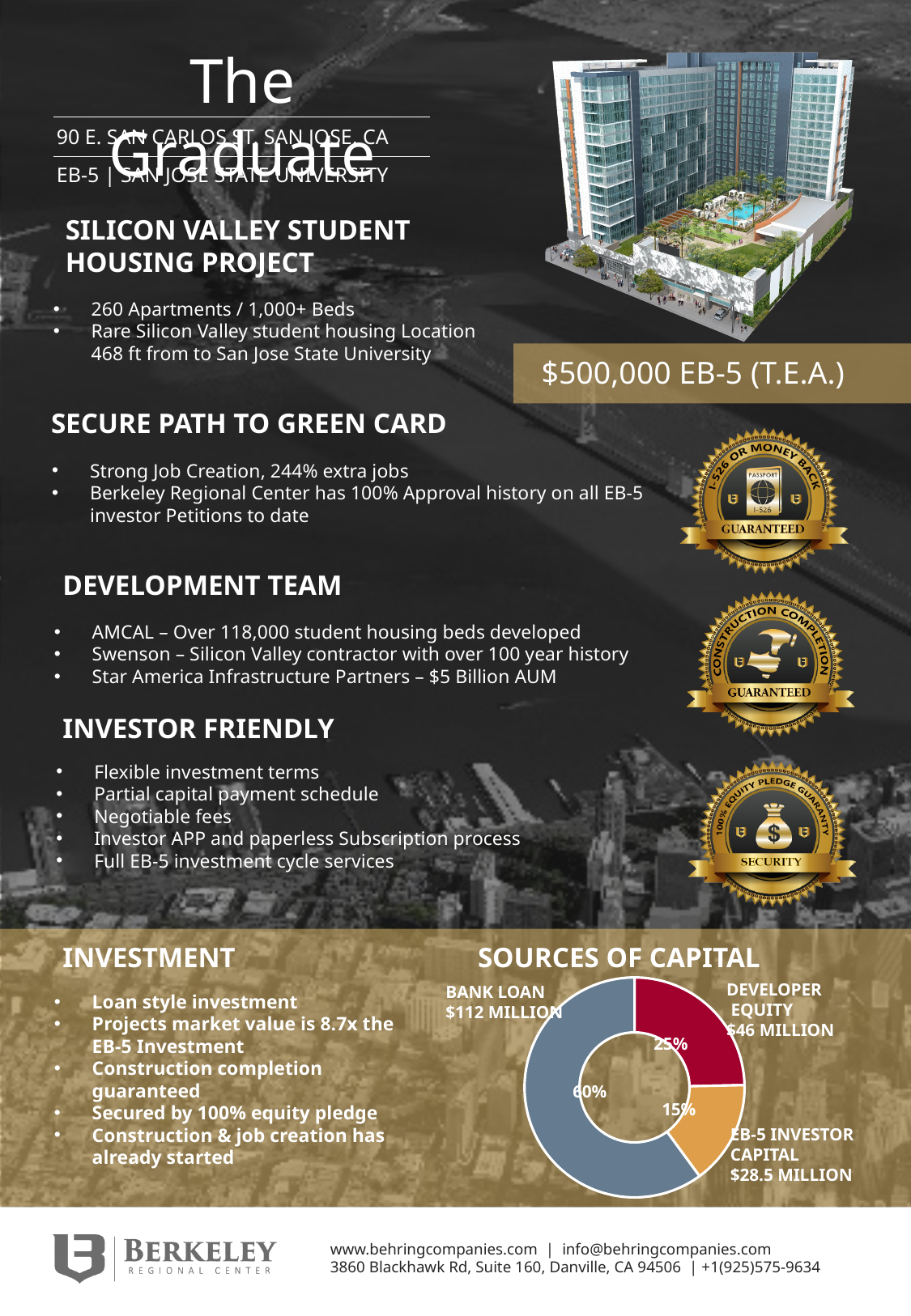
In the Sources of Capital chart, what is the difference in percentage share between the Bank Loan and Developer Equity? 35% In the Sources of Capital chart, what percentage share does the Bank Loan represent? 60% In the Sources of Capital chart, what percentage share does Developer Equity represent? 25% How many sources of capital are shown in the Sources of Capital chart? 3 In the Sources of Capital chart, what is the dollar amount of the Bank Loan? $112 million In the Sources of Capital chart, which is larger: Developer Equity or EB-5 Investor Capital? Developer Equity What kind of chart is shown under "SOURCES OF CAPITAL"? Donut (pie) chart In the Sources of Capital chart, what is the dollar amount of Developer Equity? $46 million In the Sources of Capital chart, what percentage share does EB-5 Investor Capital represent? 15% In the Sources of Capital chart, what is the dollar amount of EB-5 Investor Capital? $28.5 million Which source of capital is the largest in the Sources of Capital chart? Bank Loan Which source of capital is the smallest in the Sources of Capital chart? EB-5 Investor Capital